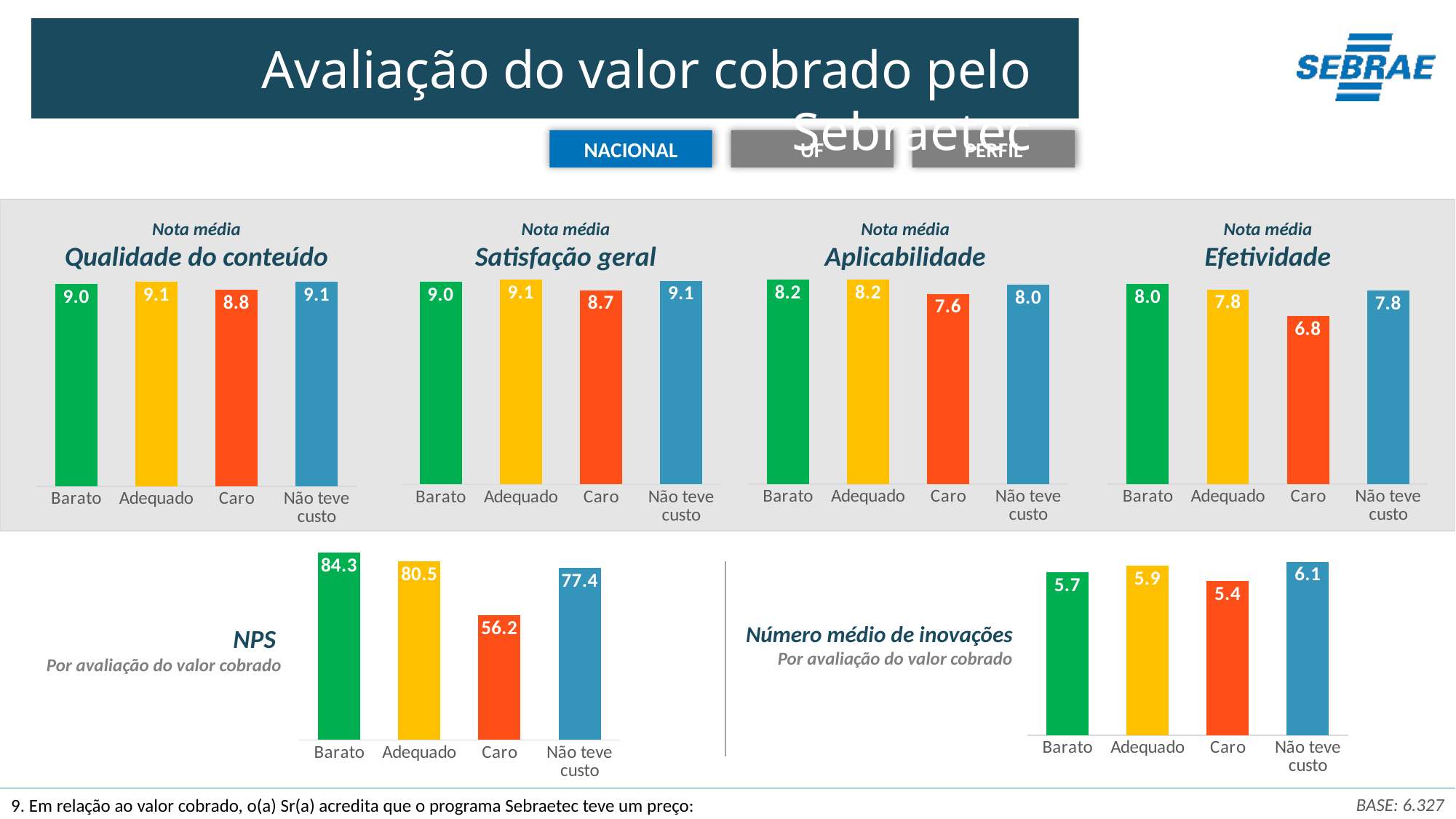
In the 'Qualidade do conteúdo' chart, what is the value for Caro? 8.8 In the 'NPS' chart, what is the value for Adequado? 80.5 In the 'Efetividade' chart, what is the difference between the values for Barato and Caro? 1.2 In the 'Efetividade' chart, which category has the highest value? Barato In the 'Satisfação geral' chart, what is the value for Não teve custo? 9.1 In the 'Aplicabilidade' chart, which category has the lowest value? Caro In the 'Número médio de inovações' chart, is the value for Adequado larger or smaller than the value for Caro? larger In the 'NPS' chart, what is the difference between the values for Barato and Caro? 28.1 What type of chart is the 'NPS' chart? bar chart How many categories are shown in the 'Satisfação geral' chart? 4 In the 'Número médio de inovações' chart, which category has the highest value? Não teve custo In the 'NPS' chart, which category has the highest value? Barato